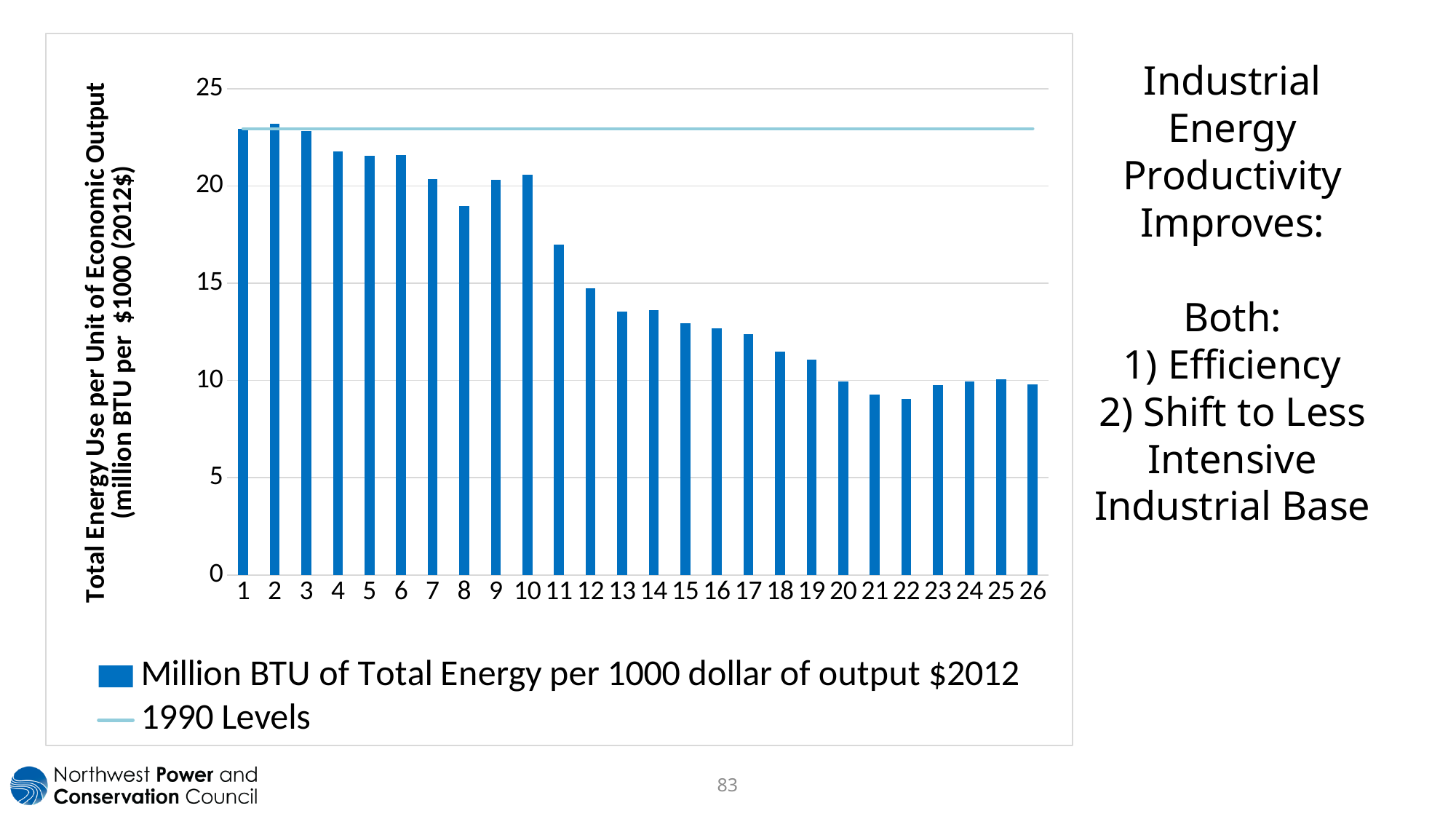
Is the value for category 8 greater or less than 20? less Is the value for category 4 greater or less than 20? greater Do the bar values generally rise or fall from category 1 to category 26? fall Which has the larger value, category 1 or category 26? category 1 What is the label of the line series in the legend? 1990 Levels How many series does the legend list? 2 What kind of chart is shown on the slide? combination bar and line chart Which has the larger value, category 11 or category 12? category 11 How many bars (categories) are plotted along the x axis? 26 Is the value for category 11 greater or less than 15? greater What is the title of the vertical axis? Total Energy Use per Unit of Economic Output (million BTU per $1000 (2012$)